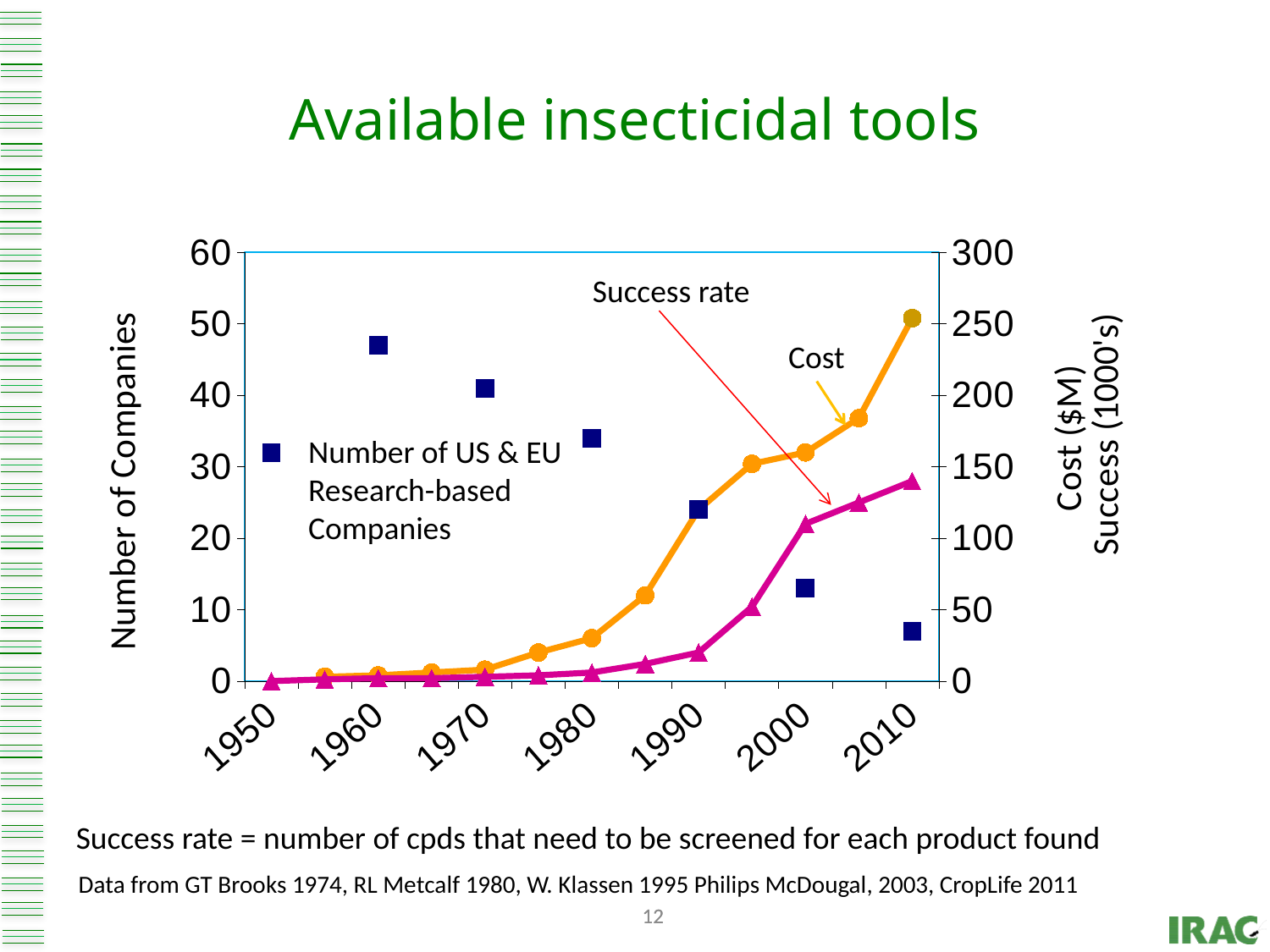
Is the Number of US & EU Research-based Companies around 1960 greater or less than 40? greater At 2010, which is higher on the right axis: Cost or Success rate? Cost Around which year is the Number of US & EU Research-based Companies highest? 1960 Do the Number of US & EU Research-based Companies points rise or fall from 1960 to 2010? fall How many blue square data points for Number of US & EU Research-based Companies are plotted? 7 What is the label on the left vertical axis? Number of Companies Does the Cost line rise or fall from 1950 to 2010? rise Is the Cost value at 2010 greater or less than 200 on the right axis? greater How many year labels are shown on the x axis? 7 Is the Number of US & EU Research-based Companies around 2010 greater or less than 10? less What is the title of the chart? Available insecticidal tools